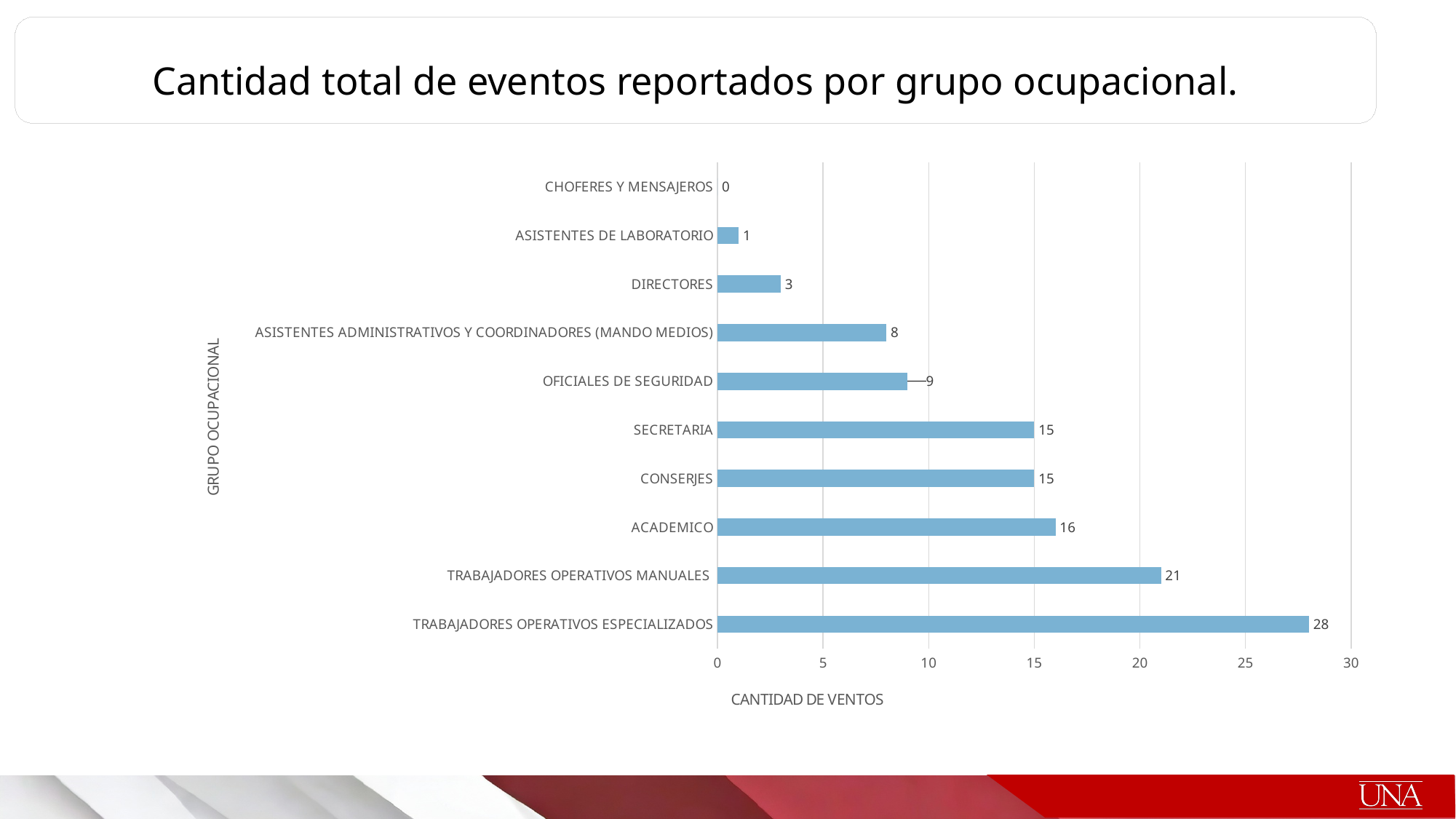
How many events are reported for TRABAJADORES OPERATIVOS ESPECIALIZADOS? 28 What is the difference between the values for SECRETARIA and ASISTENTES DE LABORATORIO? 14 How many occupational groups are shown in the chart? 10 What is the label of the horizontal axis? CANTIDAD DE VENTOS Which occupational group has the lowest number of reported events? CHOFERES Y MENSAJEROS What is the value for ASISTENTES ADMINISTRATIVOS Y COORDINADORES (MANDO MEDIOS)? 8 What type of chart is shown on the slide? Bar chart Which has a larger value, ACADEMICO or DIRECTORES? ACADEMICO What is the title of the chart? Cantidad total de eventos reportados por grupo ocupacional. Which occupational group has the highest number of reported events? TRABAJADORES OPERATIVOS ESPECIALIZADOS What is the difference between the values for TRABAJADORES OPERATIVOS ESPECIALIZADOS and TRABAJADORES OPERATIVOS MANUALES? 7 What is the value for OFICIALES DE SEGURIDAD? 9